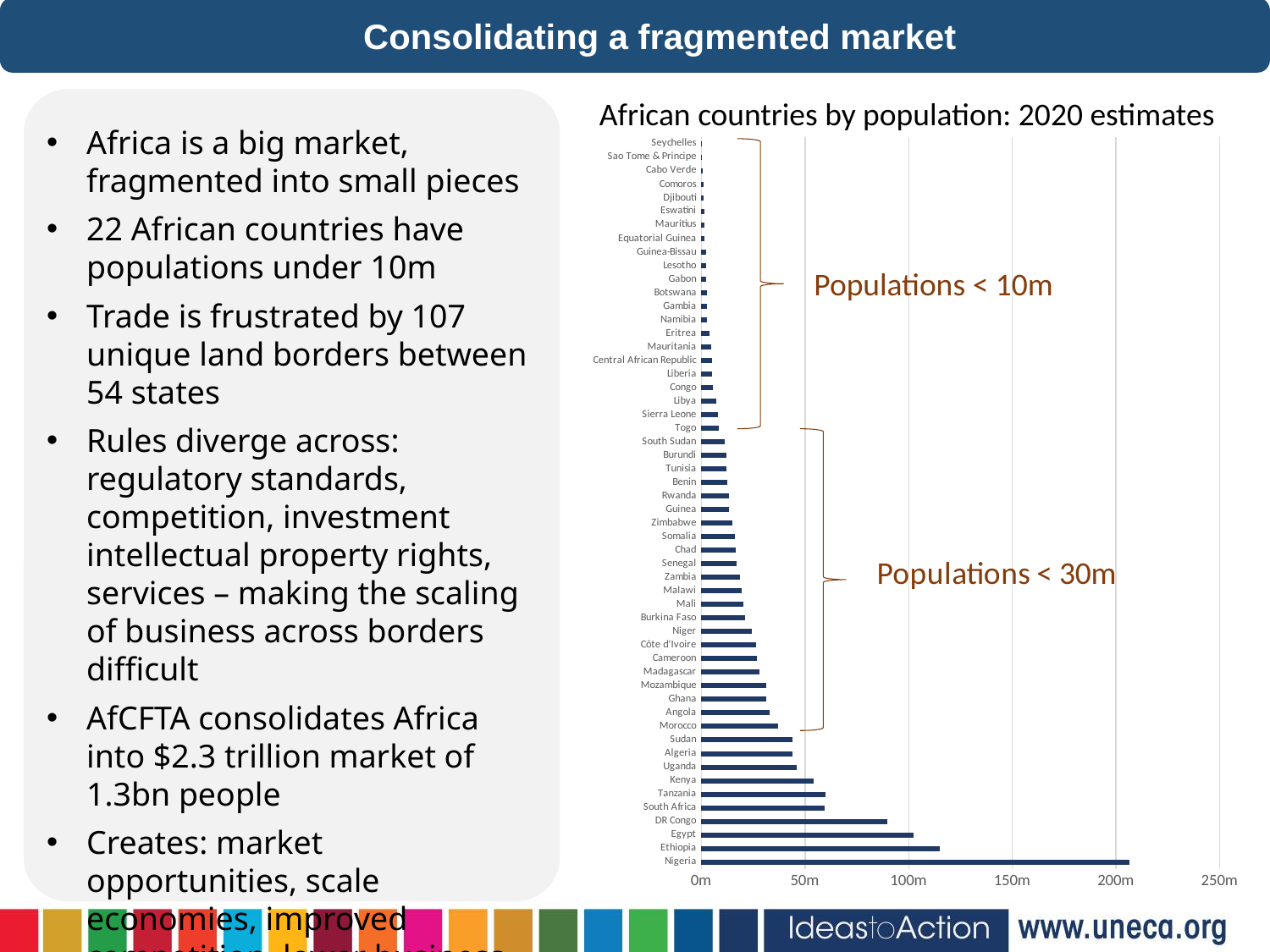
What kind of chart is shown on the slide? Bar chart Is the value for Ethiopia greater or less than 100m? greater Is the value for Nigeria greater or less than 150m? greater Is the value for DR Congo greater or less than 100m? less Which country has the smallest population in the chart? Seychelles Which country has the largest population in the chart? Nigeria What is the title of the chart? African countries by population: 2020 estimates What are the two bracket annotations on the chart labelled? Populations < 10m and Populations < 30m Which has the larger population, Nigeria or Ethiopia? Nigeria How many countries are plotted in the chart? 54 Which has the larger population, Ethiopia or Egypt? Ethiopia